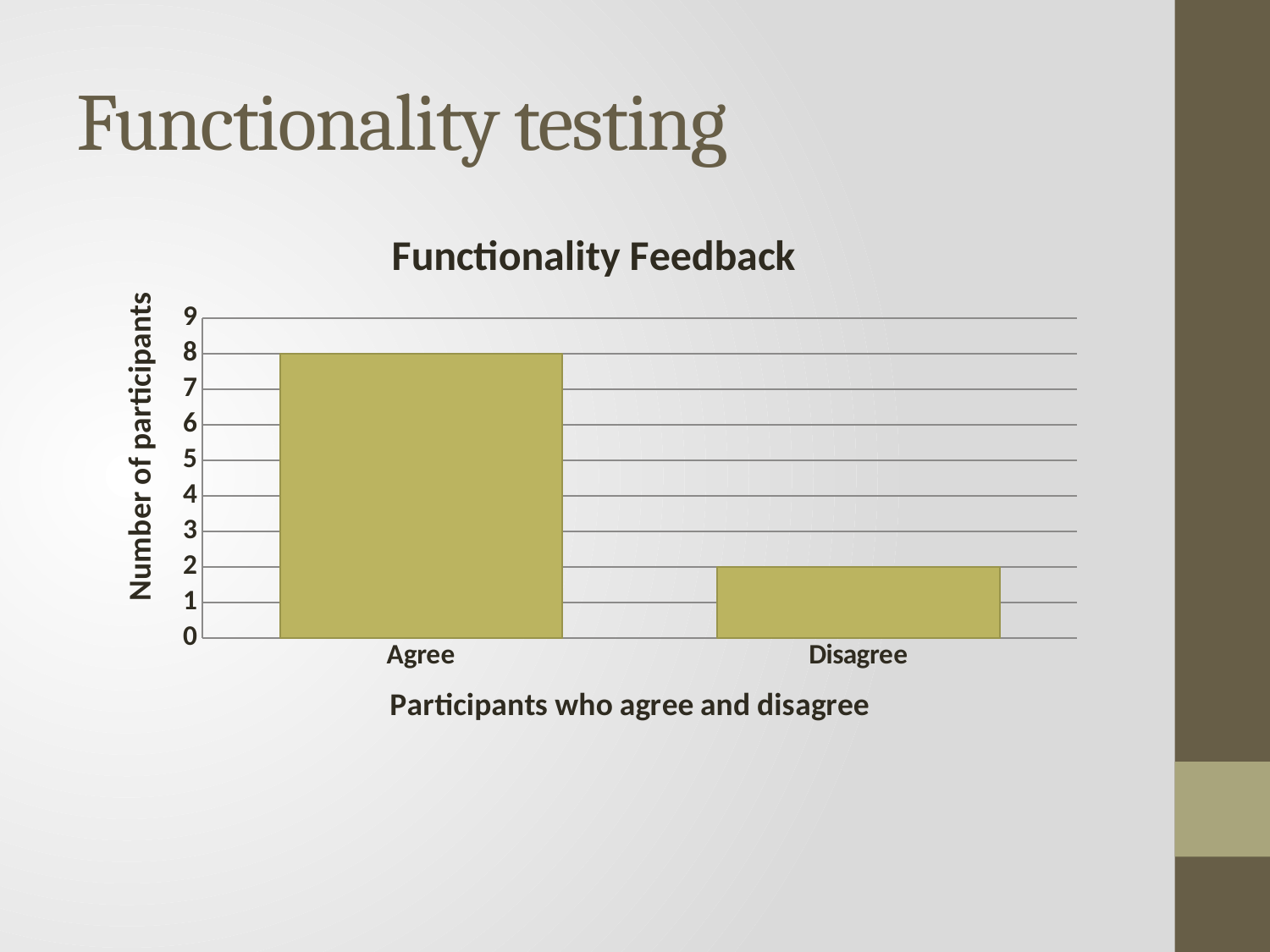
What is the number of participants for Agree? 8 What kind of chart is shown on the slide? bar chart How many categories are shown on the x axis? 2 Which category has the lowest number of participants? Disagree What is the number of participants for Disagree? 2 Is the value for Agree greater or less than 5? greater Which category has the highest number of participants? Agree What is the difference in number of participants between Agree and Disagree? 6 Which has more participants, Agree or Disagree? Agree What is the label of the y axis? Number of participants Is the value for Disagree greater or less than 4? less What is the title of the chart? Functionality Feedback